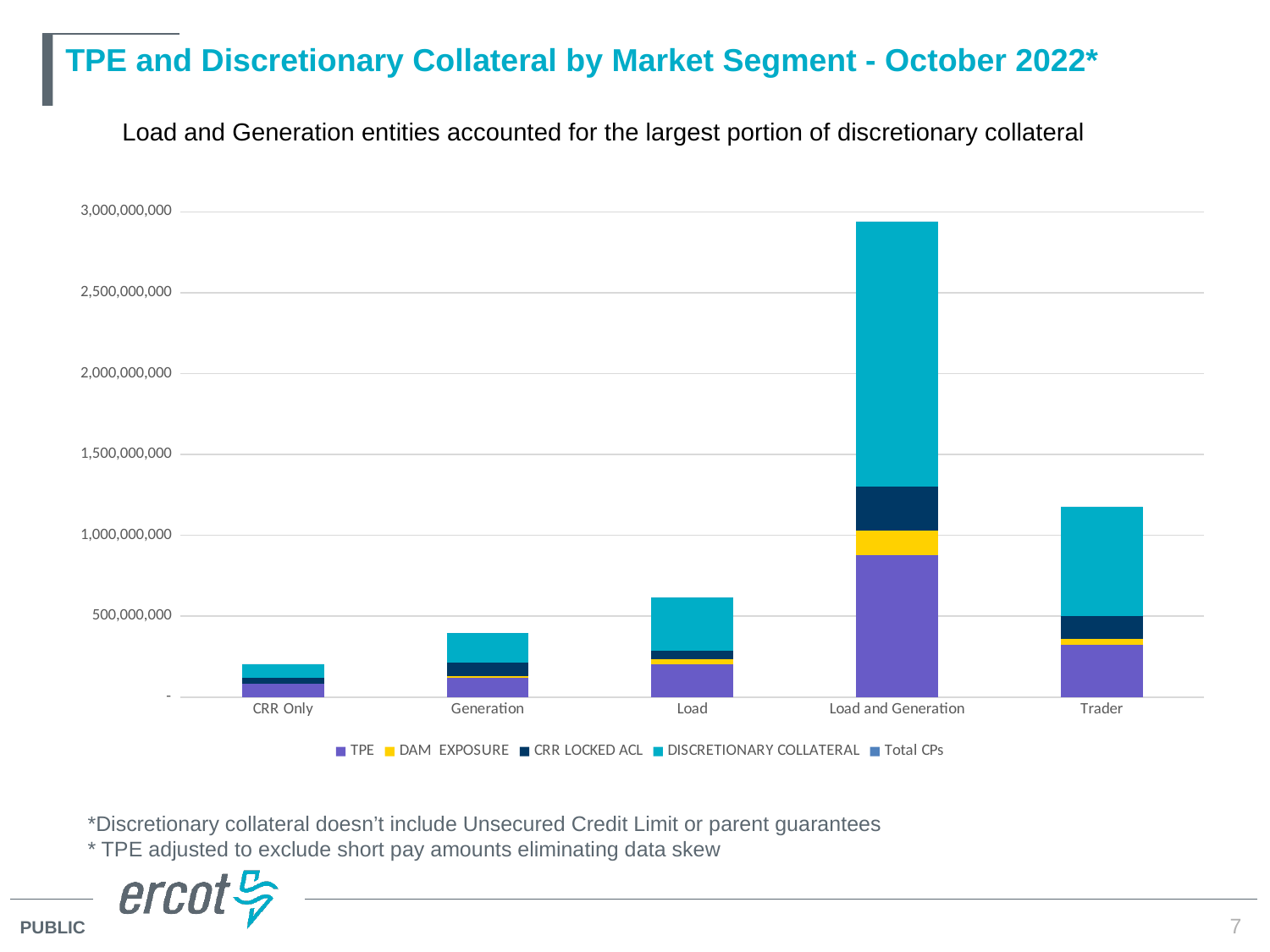
Which market segment has the tallest stacked bar? Load and Generation Is the total stacked value for CRR Only greater or less than 500,000,000? less Is the total stacked value for Trader greater or less than 1,000,000,000? greater What kind of chart is shown on the slide? Stacked bar chart How many series does the legend list? 5 Is the total stacked value for Load and Generation greater or less than 2,500,000,000? greater Which market segment has the shortest stacked bar? CRR Only Which has the larger total stacked bar, Trader or Load? Trader What is the title of the slide containing the chart? TPE and Discretionary Collateral by Market Segment - October 2022* How many market segment categories are shown on the x axis? 5 Which series forms the top (light blue) segment of each stacked bar? DISCRETIONARY COLLATERAL